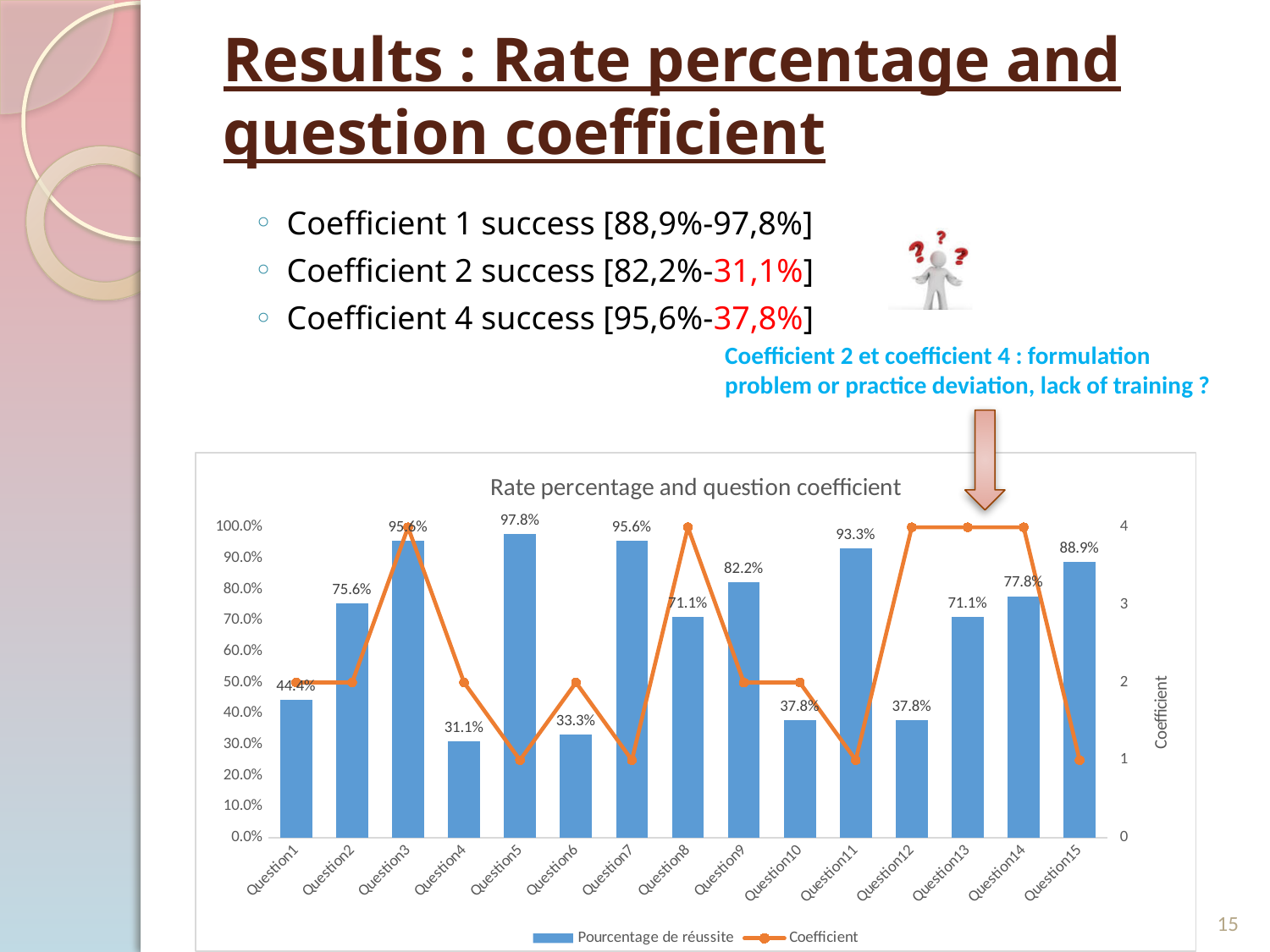
What is the title of the chart? Rate percentage and question coefficient What is the Coefficient value for Question3? 4 How many series does the chart legend list? 2 What is the Coefficient value for Question5? 1 What is the Pourcentage de réussite for Question5? 97.8% What is the difference between the Pourcentage de réussite for Question9 and Question10? 44.4% Which question has the lowest Pourcentage de réussite? Question4 Which has a higher Pourcentage de réussite, Question2 or Question14? Question14 What kind of chart is shown on the slide? Combined bar and line chart What is the Pourcentage de réussite for Question4? 31.1% Which question has the highest Pourcentage de réussite? Question5 How many questions are shown on the x axis of the chart? 15